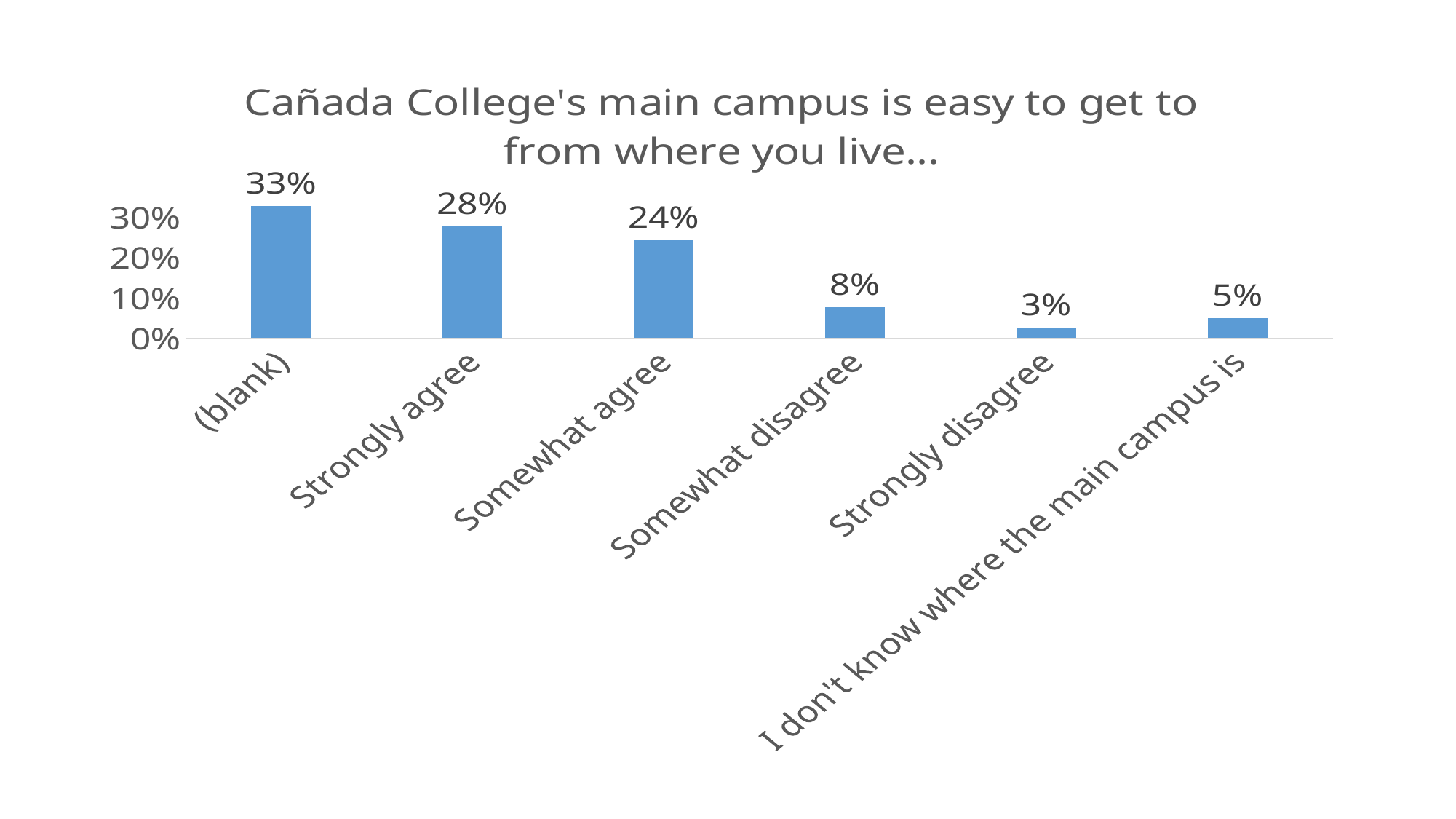
Which is larger, "Somewhat disagree" or "I don't know where the main campus is"? Somewhat disagree Which category has the lowest value? Strongly disagree What percentage of respondents chose "Strongly agree"? 28% What is the value for "(blank)"? 33% How many categories are shown on the x axis? 6 What is the difference between "Strongly agree" and "Somewhat agree"? 4% What kind of chart is this? Bar chart What is the value for "I don't know where the main campus is"? 5% Is the value for "Somewhat agree" greater or less than 20%? greater What is the title of the chart? Cañada College's main campus is easy to get to from where you live... Which category has the highest value? (blank) What is the value for "Somewhat disagree"? 8%